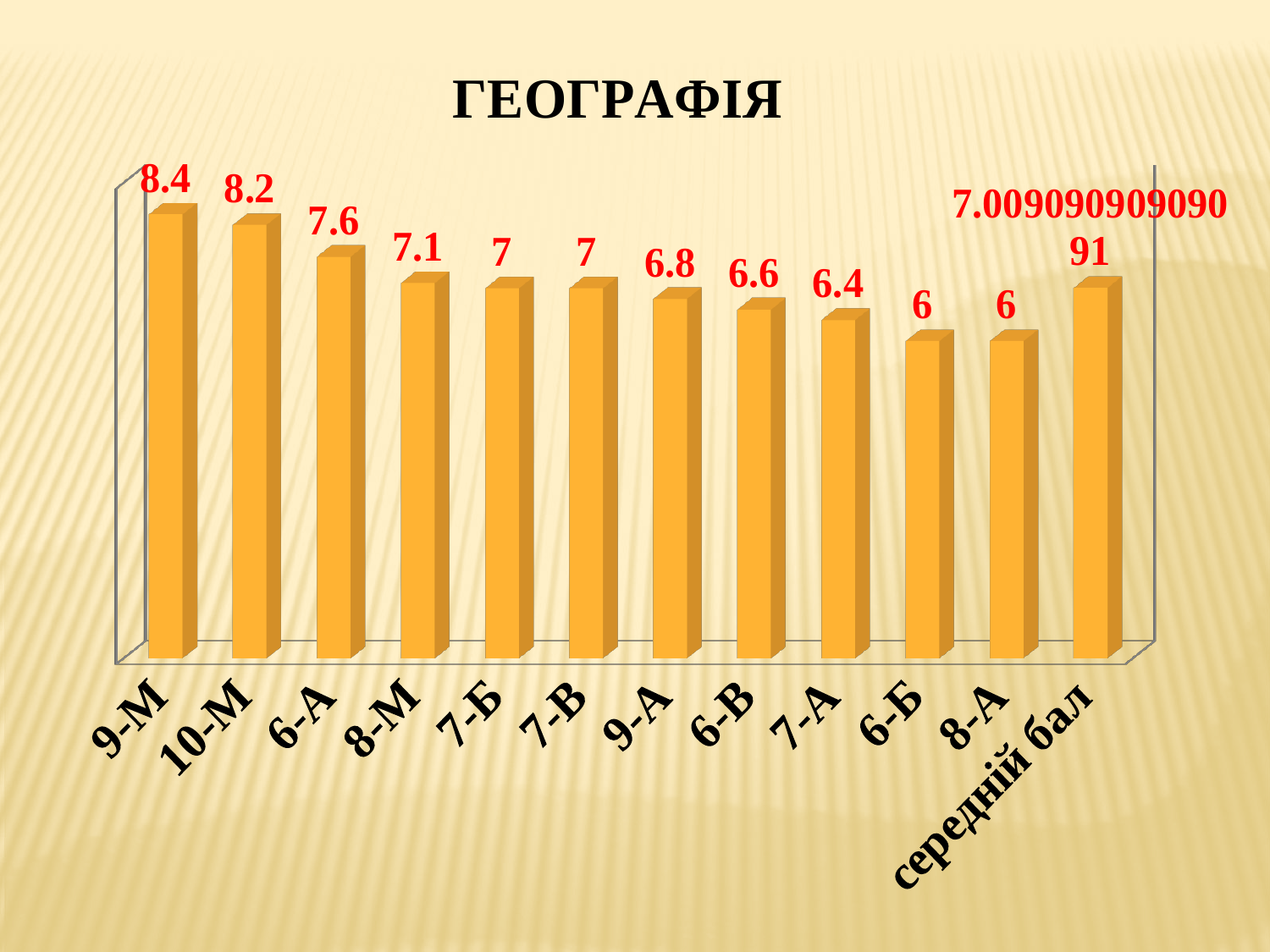
What is the lowest value shown on the chart? 6 What is the difference between the values for 9-М and 10-М? 0.2 Which category has the highest value? 9-М How many bars are shown on the chart? 12 What is the title of the chart? ГЕОГРАФІЯ What is the value for 6-А? 7.6 What is the difference between the values for 6-А and 8-М? 0.5 What is the value for 8-М? 7.1 Which is larger, the value for 9-А or the value for 6-В? 9-А What is the value for 7-А? 6.4 What is the value for 9-М? 8.4 What kind of chart is shown on the slide? Bar chart